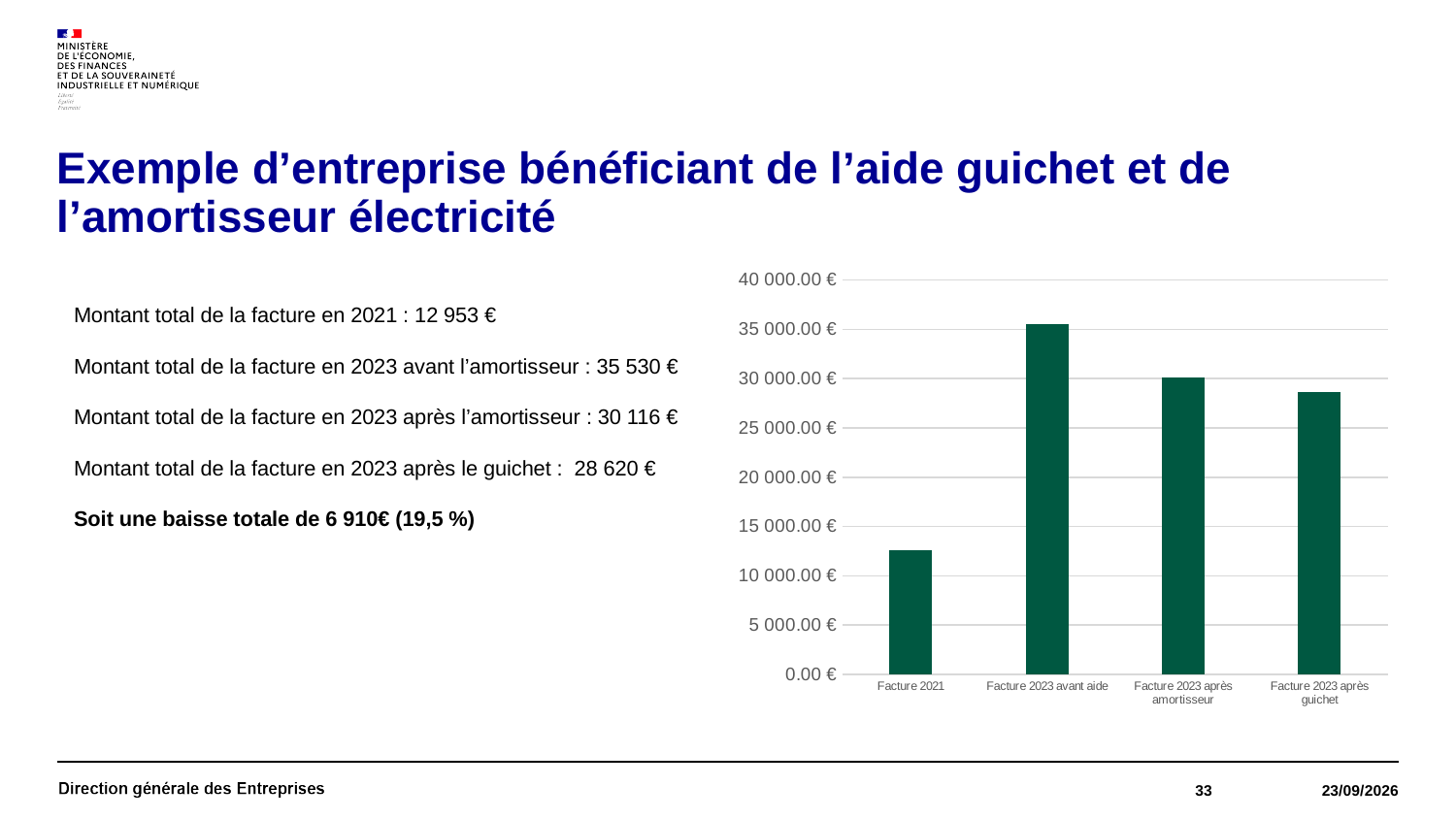
Do the bars rise or fall from Facture 2023 avant aide to Facture 2023 après guichet? fall Is the value for Facture 2021 greater or less than 15 000.00 €? less What is the highest value shown on the chart's vertical axis? 40 000.00 € Which is larger, the bar for Facture 2023 après amortisseur or the bar for Facture 2023 après guichet? Facture 2023 après amortisseur Which category has the lowest bar? Facture 2021 Is the value for Facture 2021 greater or less than 10 000.00 €? greater How many bars does the chart show? 4 What kind of chart is shown on the slide? bar chart Which category has the highest bar? Facture 2023 avant aide Is the value for Facture 2023 avant aide greater or less than 35 000.00 €? greater Which is larger, the bar for Facture 2021 or the bar for Facture 2023 avant aide? Facture 2023 avant aide